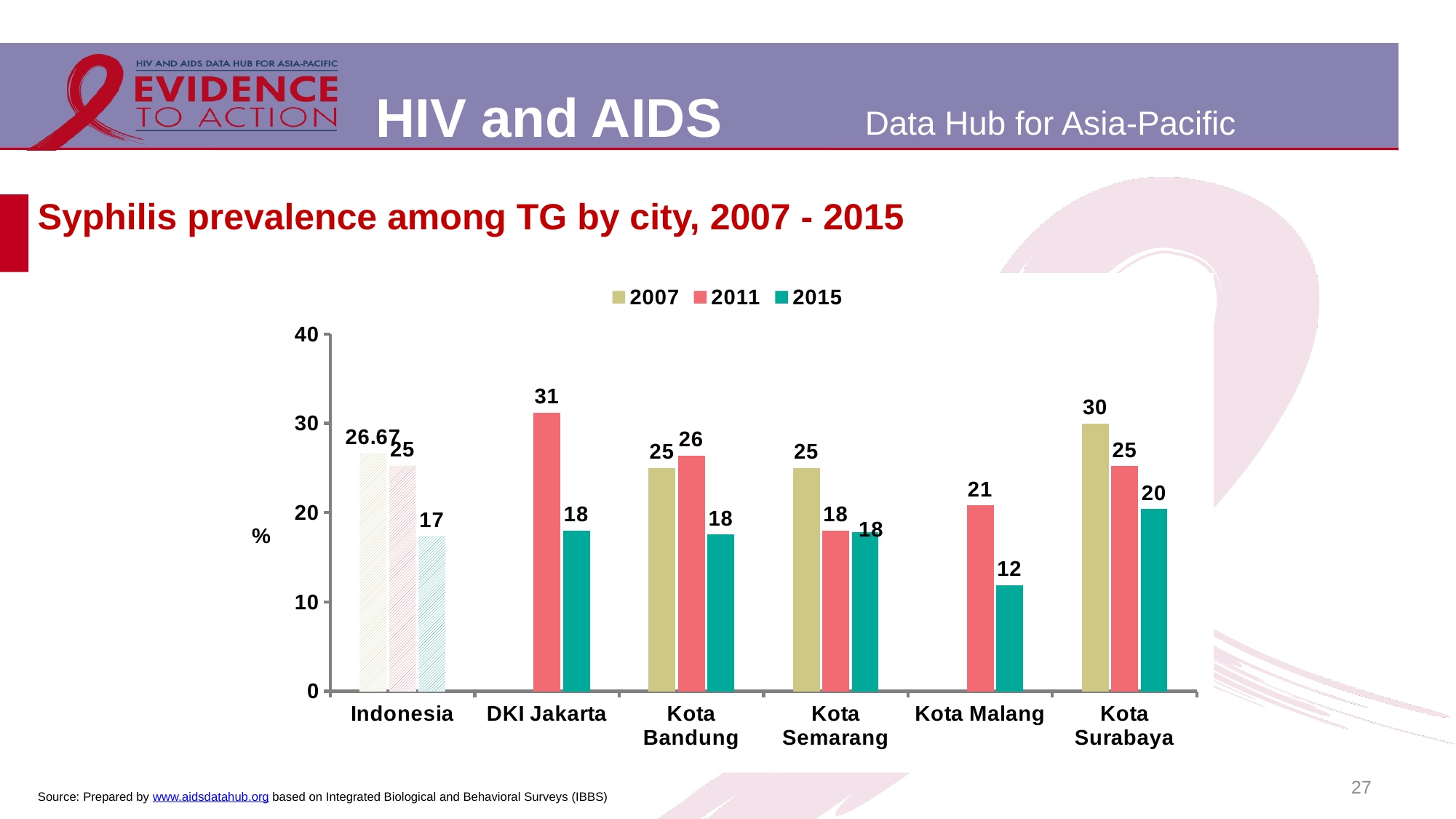
What is the 2011 value for DKI Jakarta? 31 How many categories are shown on the x axis? 6 What is the difference between the 2011 and 2015 values for DKI Jakarta? 13 What is the difference between the 2007 and 2015 values for Kota Surabaya? 10 What is the 2007 value for Indonesia? 26.67 Which category has the lowest 2015 value? Kota Malang What is the 2015 value for Kota Malang? 12 How many series does the legend list? 3 What kind of chart is shown on the slide? bar chart For Kota Bandung, which year has the larger value, 2007 or 2011? 2011 Which city has the highest 2011 value? DKI Jakarta Do the values for Kota Surabaya rise or fall from 2007 to 2015? fall